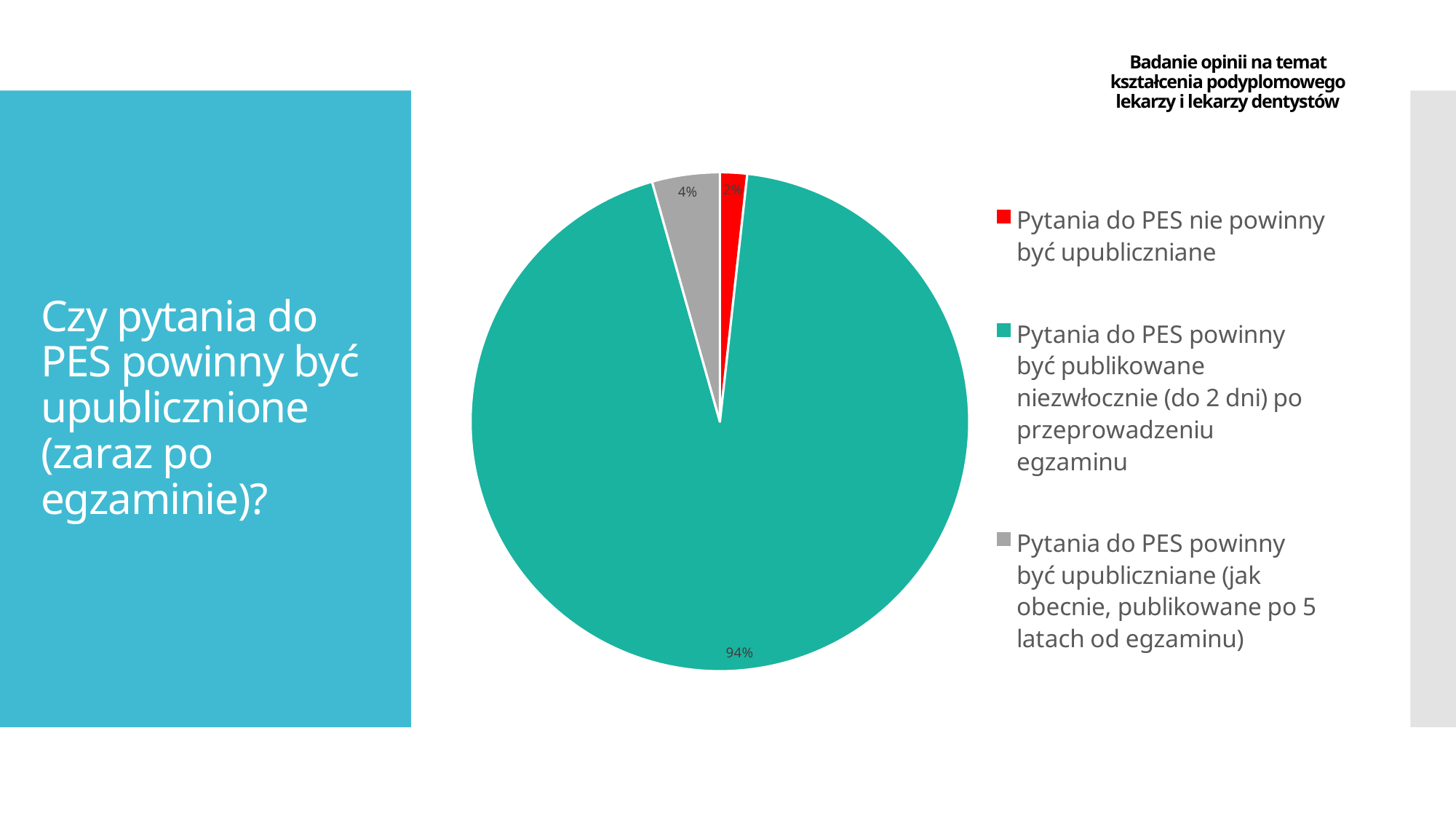
What colour is the slice for 'Pytania do PES nie powinny być upubliczniane'? red What colour is the largest slice of the pie? teal (green) Which category has the largest slice of the pie? Pytania do PES powinny być publikowane niezwłocznie (do 2 dni) po przeprowadzeniu egzaminu Which category has the smallest slice of the pie? Pytania do PES nie powinny być upubliczniane What kind of chart is shown on the slide? pie chart What is the difference in percentage points between the 94% slice and the 4% slice? 90 percentage points What share of the pie is labelled 'Pytania do PES nie powinny być upubliczniane'? 2% How many categories does the pie chart show? 3 What share of the pie is labelled 'Pytania do PES powinny być publikowane niezwłocznie (do 2 dni) po przeprowadzeniu egzaminu'? 94% How many entries does the legend list? 3 What share of the pie is labelled 'Pytania do PES powinny być upubliczniane (jak obecnie, publikowane po 5 latach od egzaminu)'? 4% Which is larger: the slice for 'Pytania do PES nie powinny być upubliczniane' or the slice for 'Pytania do PES powinny być upubliczniane (jak obecnie, publikowane po 5 latach od egzaminu)'? Pytania do PES powinny być upubliczniane (jak obecnie, publikowane po 5 latach od egzaminu)